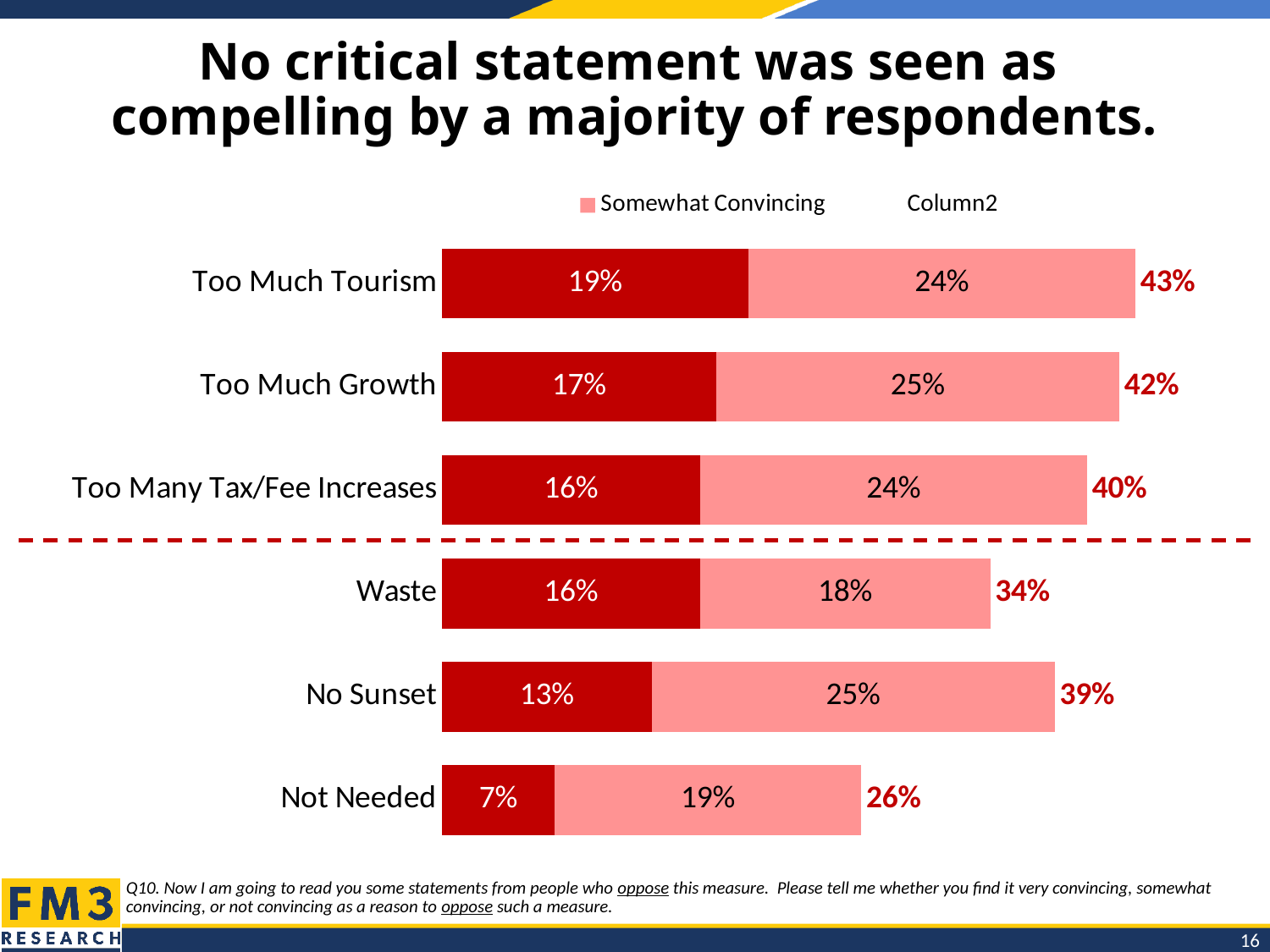
What is the total value shown for Too Many Tax/Fee Increases? 40% What is the total value shown at the end of the bar for Too Much Tourism? 43% Which has the larger total value, Waste or No Sunset? No Sunset What two entries appear in the chart's legend? Somewhat Convincing and Column2 How many statements (categories) are plotted in the chart? 6 What kind of chart is shown on the slide? Stacked bar chart What is the Somewhat Convincing value for Too Much Growth? 25% What is the value of the dark red segment for No Sunset? 13% Which statement has the highest total value? Too Much Tourism Which statement has the lowest total value? Not Needed Which statement has the lowest Somewhat Convincing value? Waste What is the difference between the total for Too Much Tourism and the total for Not Needed? 17 percentage points